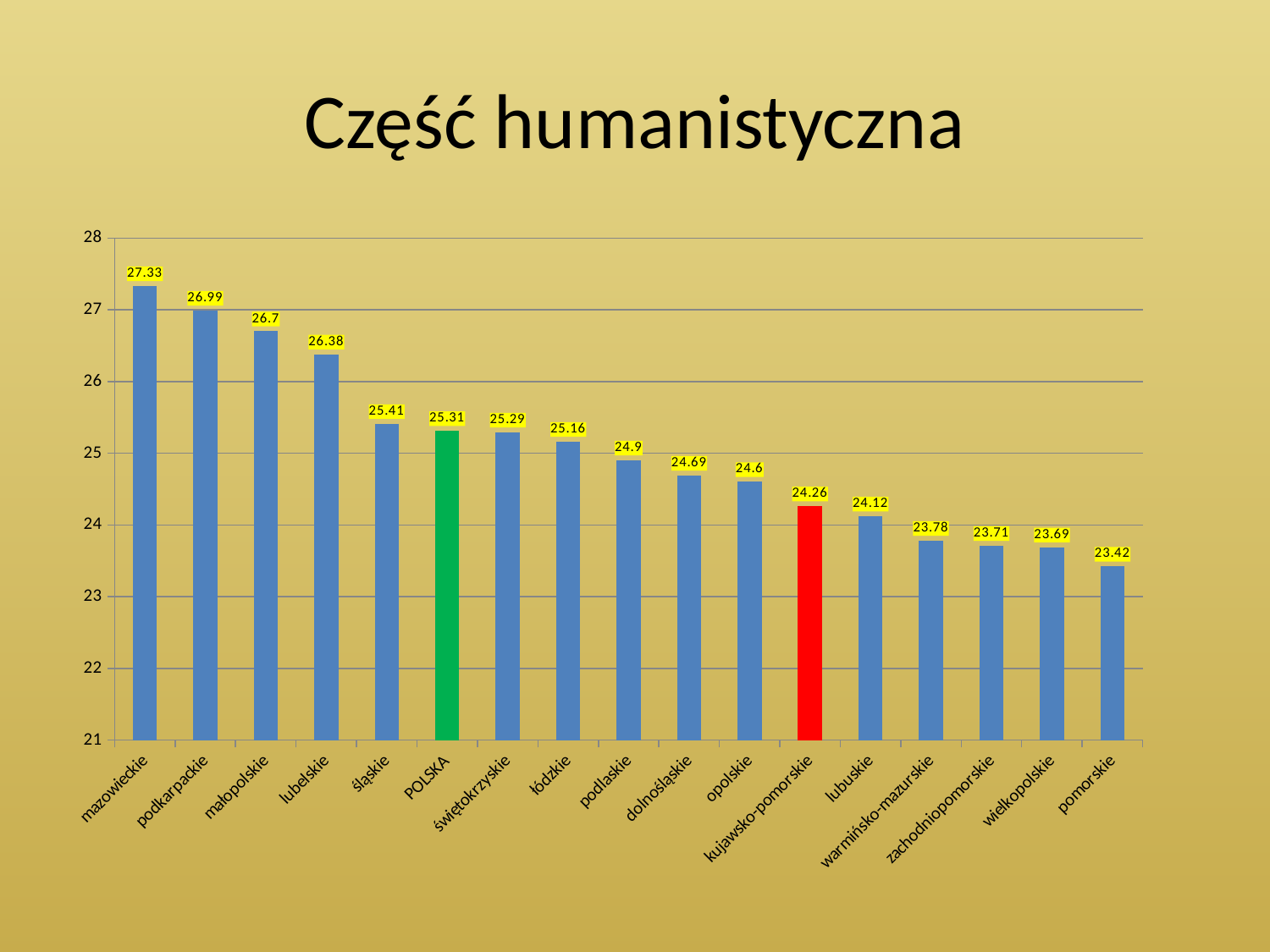
How many bars are shown in the chart? 17 What is the value for pomorskie? 23.42 Which bar is coloured red? kujawsko-pomorskie What is the difference between the values for mazowieckie and pomorskie? 3.91 What is the difference between the values for POLSKA and kujawsko-pomorskie? 1.05 Which is larger, the value for lubelskie or the value for śląskie? lubelskie Which category has the highest value? mazowieckie What is the value for mazowieckie? 27.33 Which category has the lowest value? pomorskie What is the value for kujawsko-pomorskie? 24.26 What kind of chart is shown on the slide? bar chart What is the value for POLSKA? 25.31